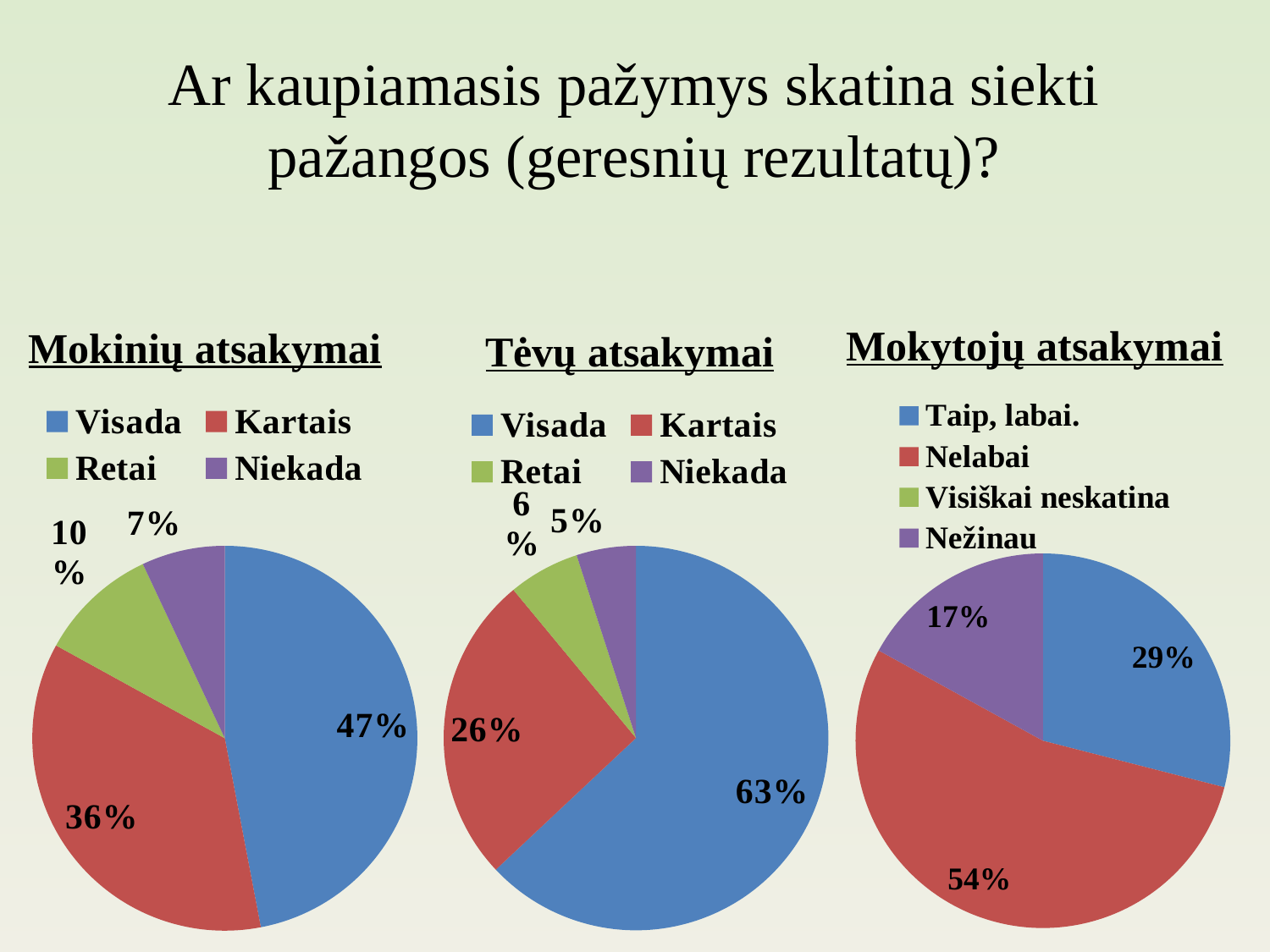
In the 'Mokinių atsakymai' chart, what percentage is shown for Retai? 10% In the 'Mokinių atsakymai' chart, what percentage is shown for Visada? 47% What type of chart is used for 'Tėvų atsakymai'? Pie chart In the 'Mokytojų atsakymai' chart, what is the difference between the Nelabai and 'Taip, labai.' shares? 25% In the 'Mokytojų atsakymai' chart, what percentage is shown for Nelabai? 54% In the 'Tėvų atsakymai' chart, which is larger, Kartais or Retai? Kartais In the 'Mokinių atsakymai' chart, which category has the smallest share? Niekada In the 'Tėvų atsakymai' chart, what percentage is shown for Niekada? 5% In the 'Mokinių atsakymai' chart, what is the difference between the Visada and Kartais shares? 11% In the 'Tėvų atsakymai' chart, which category has the largest share? Visada How many legend entries does the 'Mokytojų atsakymai' chart list? 4 In the 'Tėvų atsakymai' chart, what percentage is shown for Visada? 63%